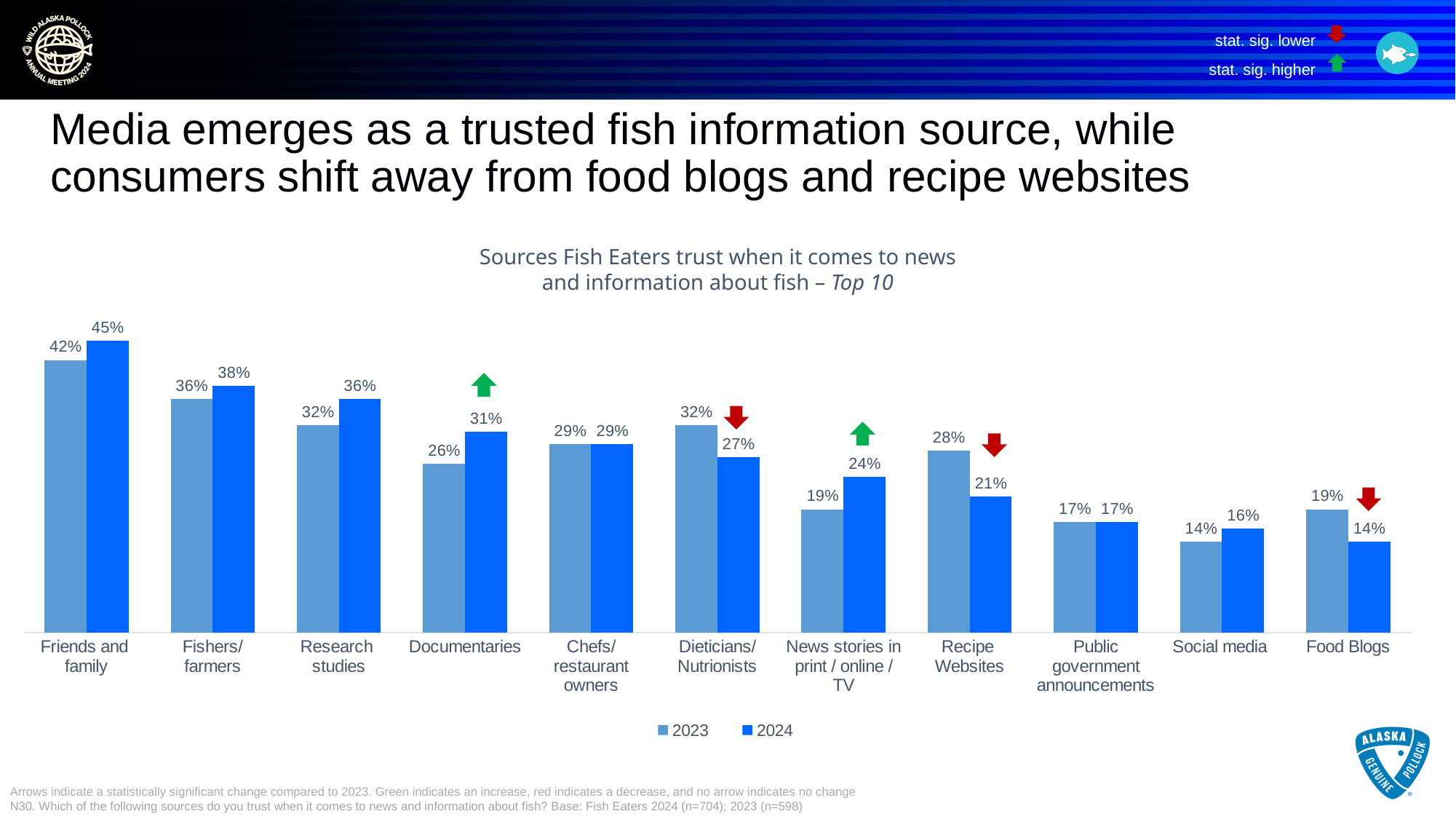
What is the difference between the 2023 and 2024 values for Documentaries? 5% What is the difference between the 2023 and 2024 values for Recipe Websites? 7% Which is larger for Dieticians/Nutrionists, the 2023 value or the 2024 value? 2023 What is the 2024 value for News stories in print / online / TV? 24% Which category has the lowest 2023 value? Social media How many categories are shown on the x axis? 11 What is the 2024 value for Friends and family? 45% How many series does the legend list? 2 What kind of chart is shown on the slide? Bar chart Which category has the highest 2024 value? Friends and family What does a green arrow above a bar indicate? Statistically significant higher (increase) What is the 2023 value for Recipe Websites? 28%